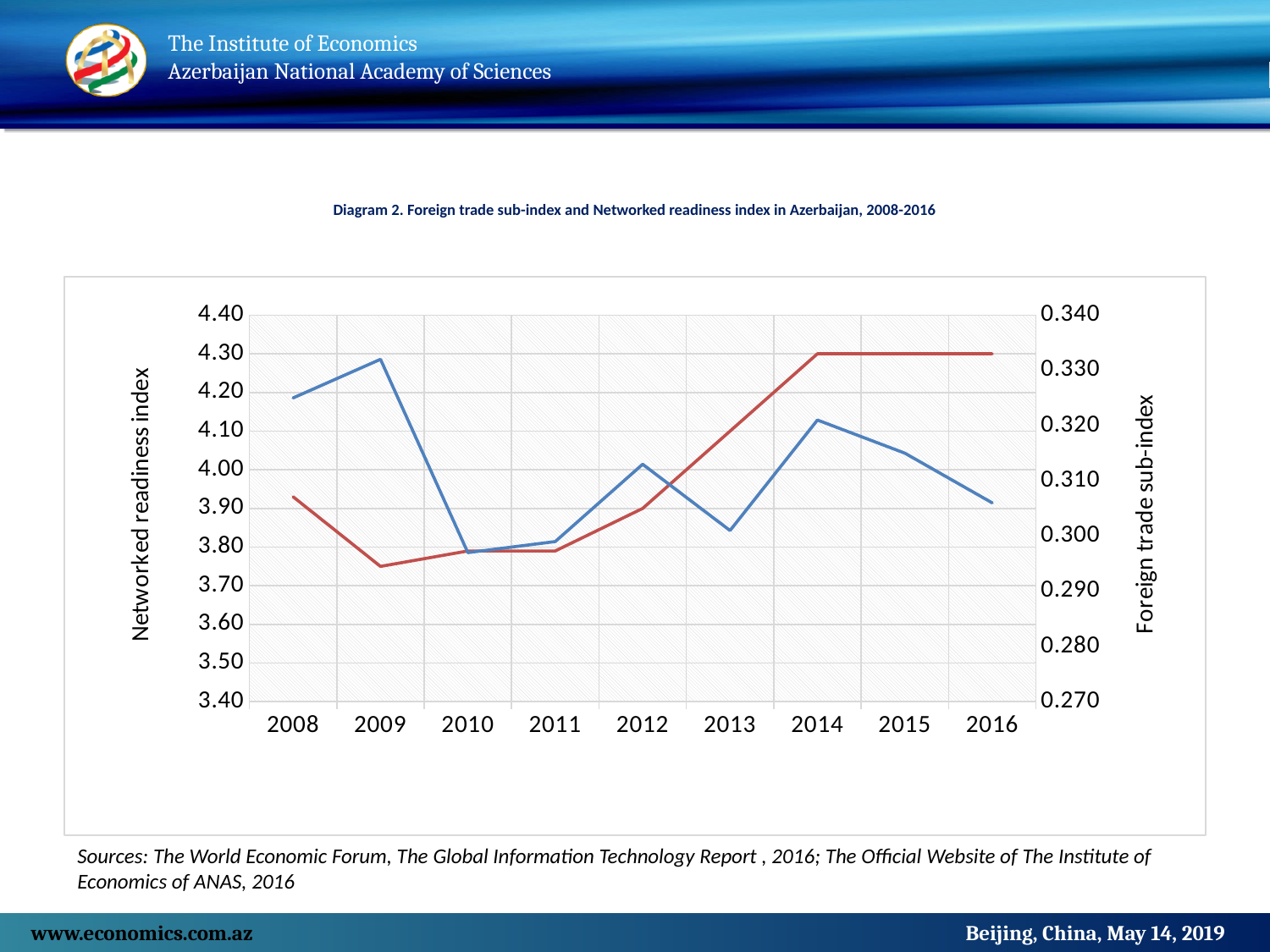
Which is larger for the blue line, the value in 2009 or the value in 2016? 2009 Does the red line rise or fall between 2011 and 2014? rise In which year does the blue line reach its highest value? 2009 What kind of chart is shown on the slide? line chart What is the title of the diagram? Diagram 2. Foreign trade sub-index and Networked readiness index in Azerbaijan, 2008-2016 What is the label of the right-hand vertical axis? Foreign trade sub-index How many years are plotted along the x axis? 9